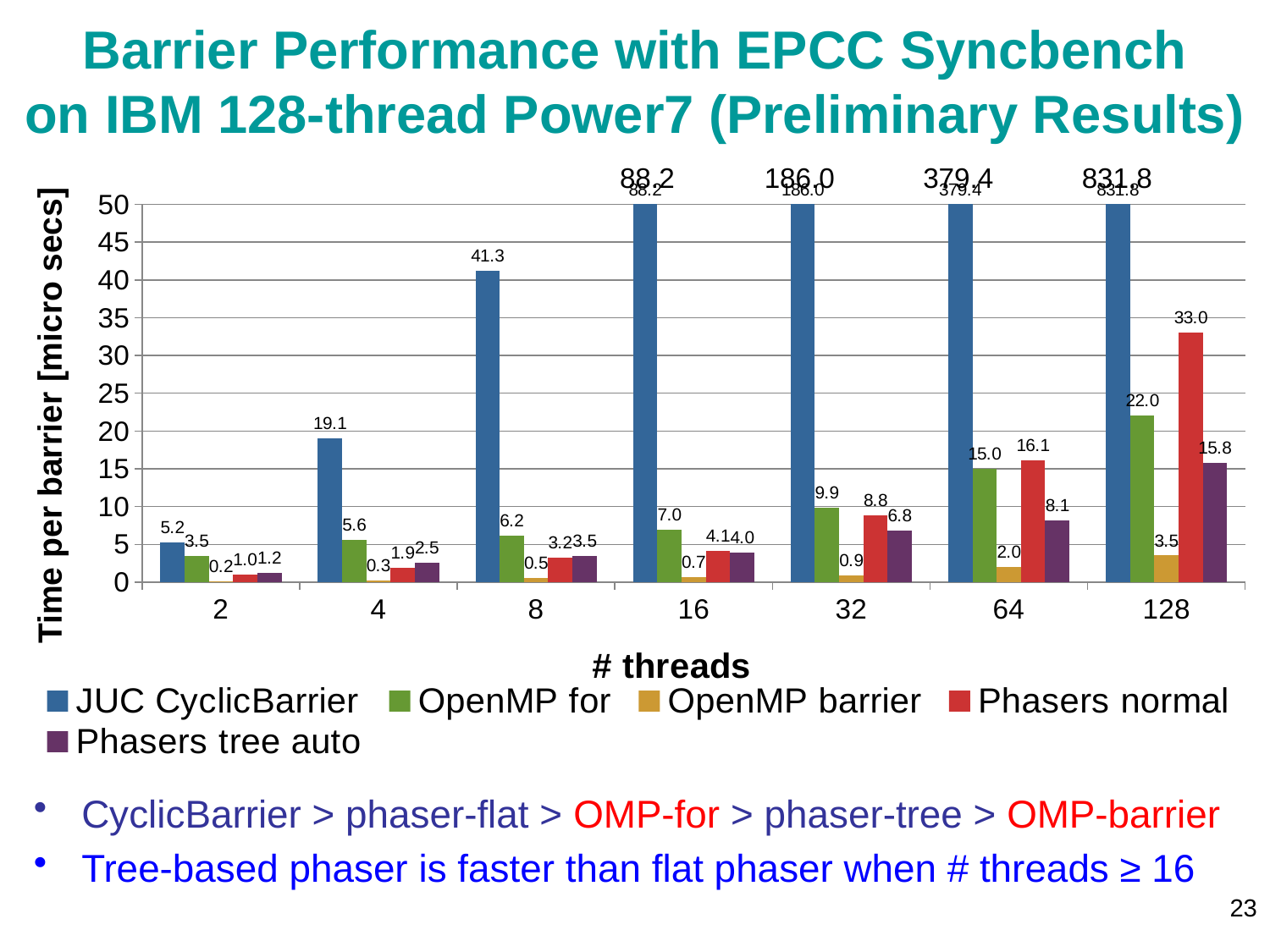
At 64 threads, which is larger: Phasers normal or OpenMP for? Phasers normal Which series has the lowest value at 16 threads? OpenMP barrier What kind of chart is shown on the slide? Bar chart What is the value for Phasers tree auto at 64 threads? 8.1 What is the value for OpenMP for at 32 threads? 9.9 What is the difference between the JUC CyclicBarrier values at 128 threads and 64 threads? 452.4 Which series has the highest value at 128 threads? JUC CyclicBarrier What is the value for Phasers normal at 128 threads? 33.0 Does the JUC CyclicBarrier value rise or fall as the number of threads increases? Rises How many series does the legend list? 5 What is the value for JUC CyclicBarrier at 8 threads? 41.3 How many thread-count categories are shown on the x axis? 7